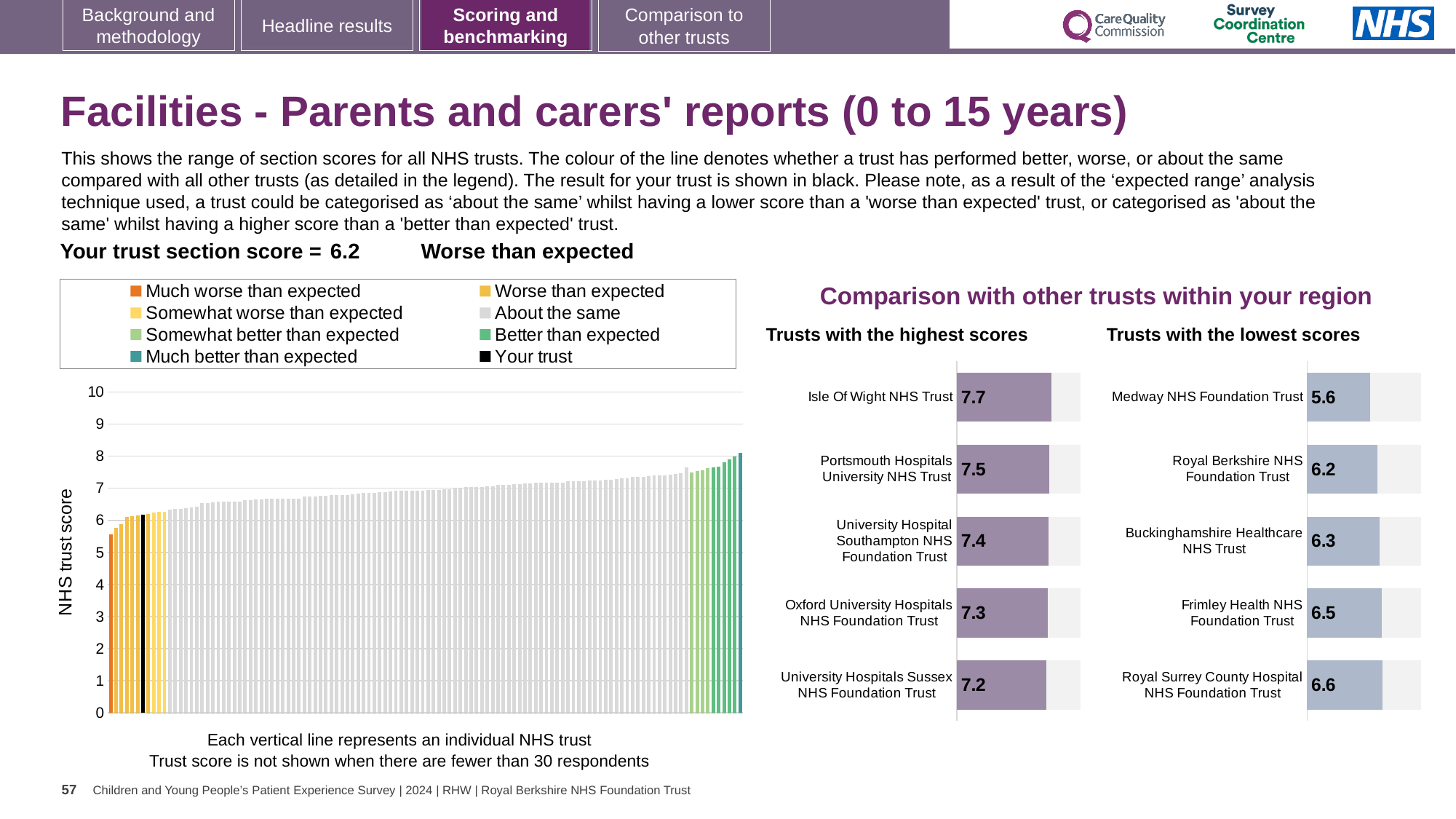
In the NHS trust score chart on the left, do the values rise or fall from left to right? Rise In the 'Trusts with the highest scores' chart, what is the difference between the scores of Isle Of Wight NHS Trust and University Hospitals Sussex NHS Foundation Trust? 0.5 In the 'Trusts with the highest scores' chart, what is the score for Oxford University Hospitals NHS Foundation Trust? 7.3 In the 'Trusts with the highest scores' chart, which trust has the highest score? Isle Of Wight NHS Trust In the 'Trusts with the lowest scores' chart, what is the score for Frimley Health NHS Foundation Trust? 6.5 How many entries does the legend of the NHS trust score chart list? 8 In the 'Trusts with the lowest scores' chart, what is the score for Medway NHS Foundation Trust? 5.6 What kind of chart is the NHS trust score chart on the left of the slide? Bar chart In the 'Trusts with the highest scores' chart, what is the score for Isle Of Wight NHS Trust? 7.7 In the 'Trusts with the lowest scores' chart, which trust has the lowest score? Medway NHS Foundation Trust In the 'Trusts with the lowest scores' chart, which has the larger score: Royal Berkshire NHS Foundation Trust or Royal Surrey County Hospital NHS Foundation Trust? Royal Surrey County Hospital NHS Foundation Trust How many trusts are shown in the 'Trusts with the lowest scores' chart? 5